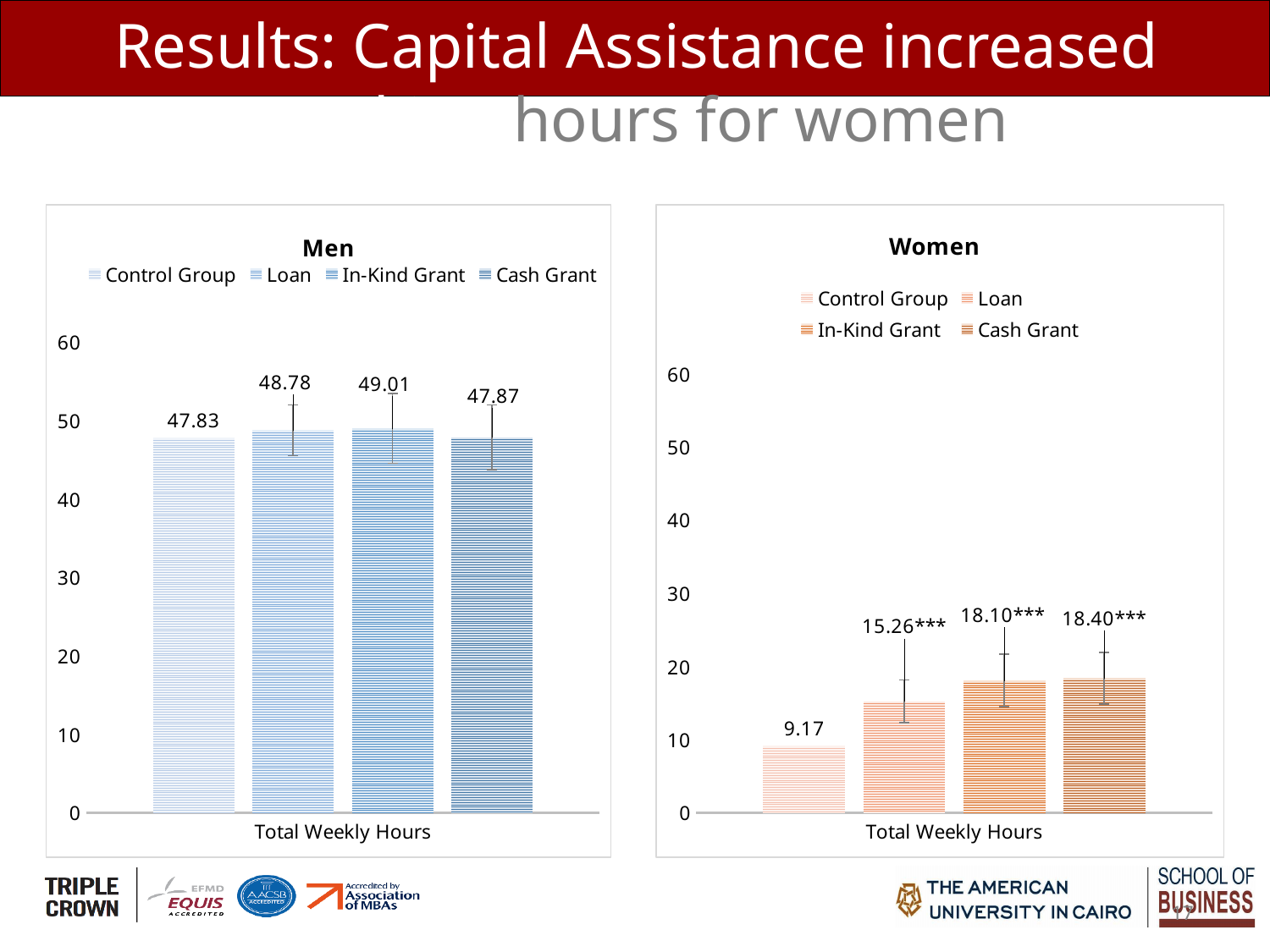
In the Men chart, which group has the highest total weekly hours? In-Kind Grant In the Women chart, is the value for the Control Group greater or less than 10? less In the Women chart, which is larger, the Loan value or the Cash Grant value? Cash Grant In the Women chart, which group has the highest total weekly hours? Cash Grant What type of chart is the Women chart? bar chart How many series does the legend of the Men chart list? 4 In the Men chart, what is the value for the Control Group? 47.83 In the Women chart, what is the value labelled for the Cash Grant group? 18.40*** In the Women chart, what is the difference between the In-Kind Grant value and the Control Group value? 8.93 In the Women chart, what is the value for the Control Group? 9.17 In the Men chart, what is the value for the In-Kind Grant group? 49.01 In the Women chart, which group has the lowest total weekly hours? Control Group